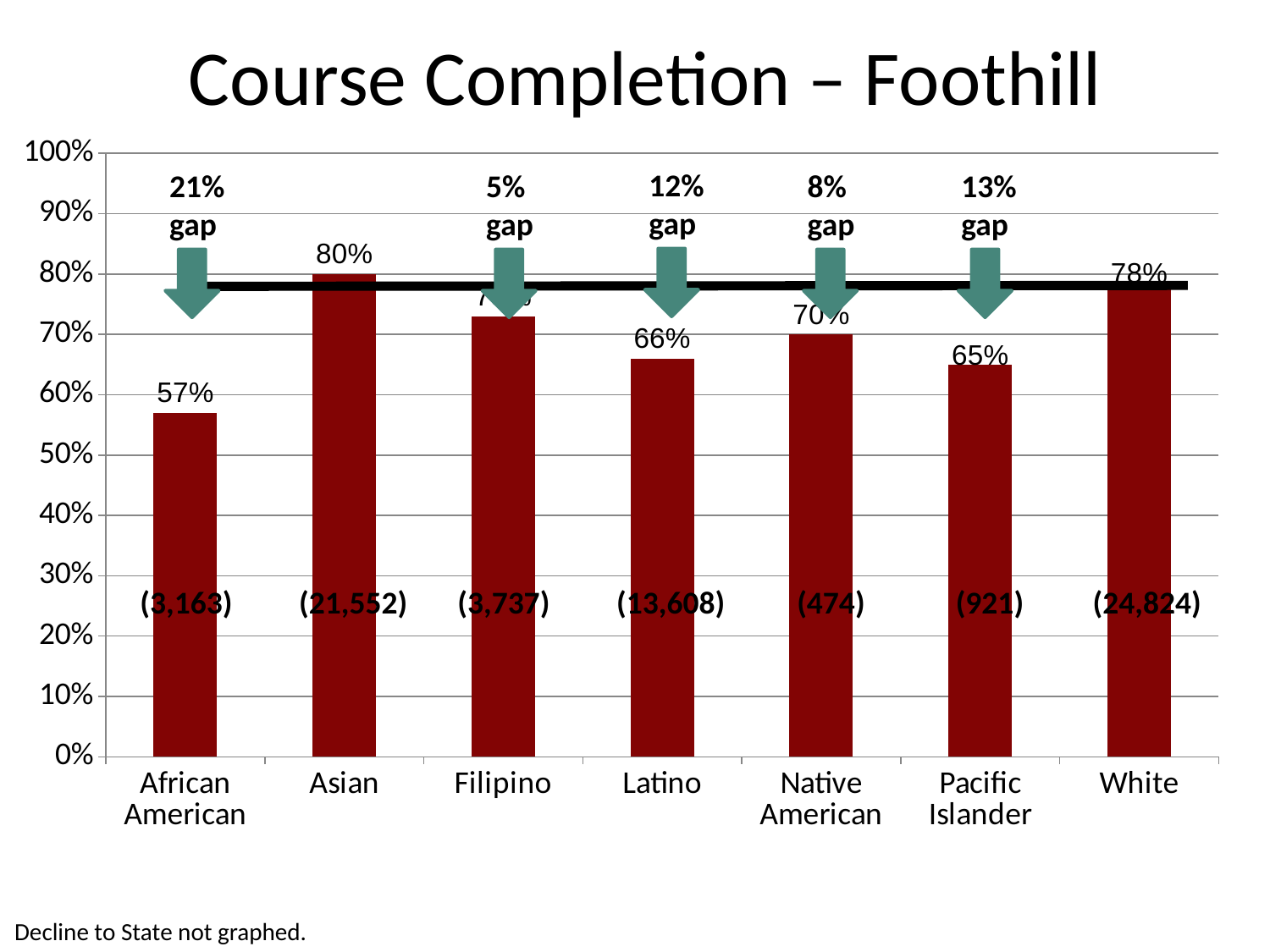
Which group has the lowest course completion rate? African American What is the difference between the course completion rates of Asian and African American students? 23% Which group has the highest course completion rate? Asian What kind of chart is shown on the slide? bar chart What is the course completion rate for Latino students? 66% What is the course completion rate for African American students? 57% What is the course completion rate for White students? 78% What gap is labeled above the African American bar? 21% gap What is the course completion rate for Asian students? 80% Which group has a higher course completion rate, Native American or Pacific Islander? Native American Is the course completion rate for Filipino students greater or less than 70%? greater How many groups are shown on the x axis of the chart? 7